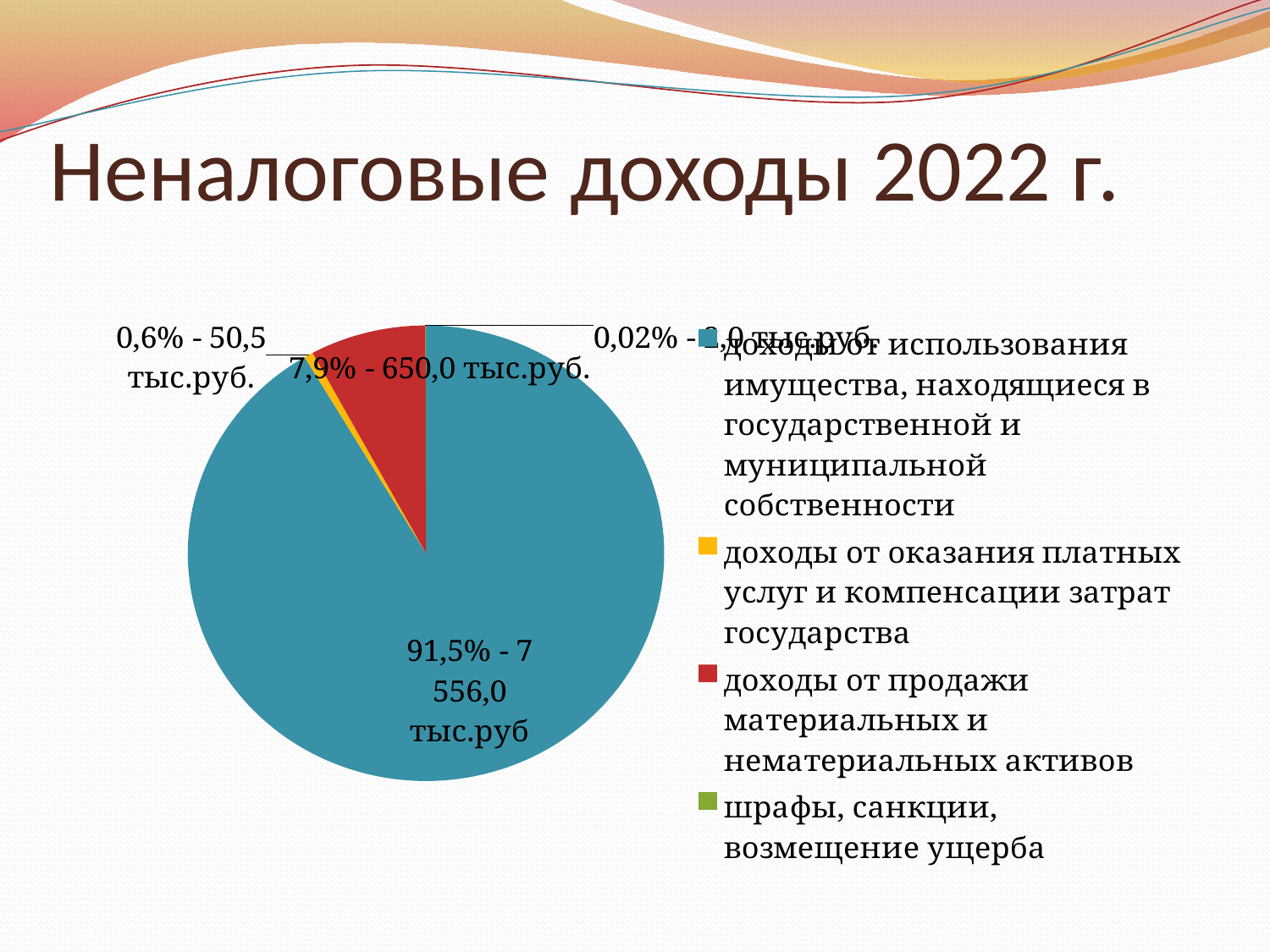
What value is printed for the slice доходы от использования имущества, находящиеся в государственной и муниципальной собственности? 7 556,0 тыс.руб Which category has the smallest slice of the pie? шрафы, санкции, возмещение ущерба Which is larger: the slice for доходы от продажи материальных и нематериальных активов or the slice for доходы от оказания платных услуг и компенсации затрат государства? доходы от продажи материальных и нематериальных активов What share of the pie does the slice for доходы от использования имущества, находящиеся в государственной и муниципальной собственности represent? 91,5% Which category has the largest slice of the pie? доходы от использования имущества, находящиеся в государственной и муниципальной собственности What value is printed for the slice доходы от оказания платных услуг и компенсации затрат государства? 50,5 тыс.руб. What is the title of the slide with the pie chart? Неналоговые доходы 2022 г. What value is printed for the slice доходы от продажи материальных и нематериальных активов? 650,0 тыс.руб. What share of the pie does the slice for штрафы, санкции, возмещение ущерба represent? 0,02% What share of the pie does the slice for доходы от продажи материальных и нематериальных активов represent? 7,9% How many categories does the legend of the pie chart list? 4 What kind of chart is shown on the slide? pie chart